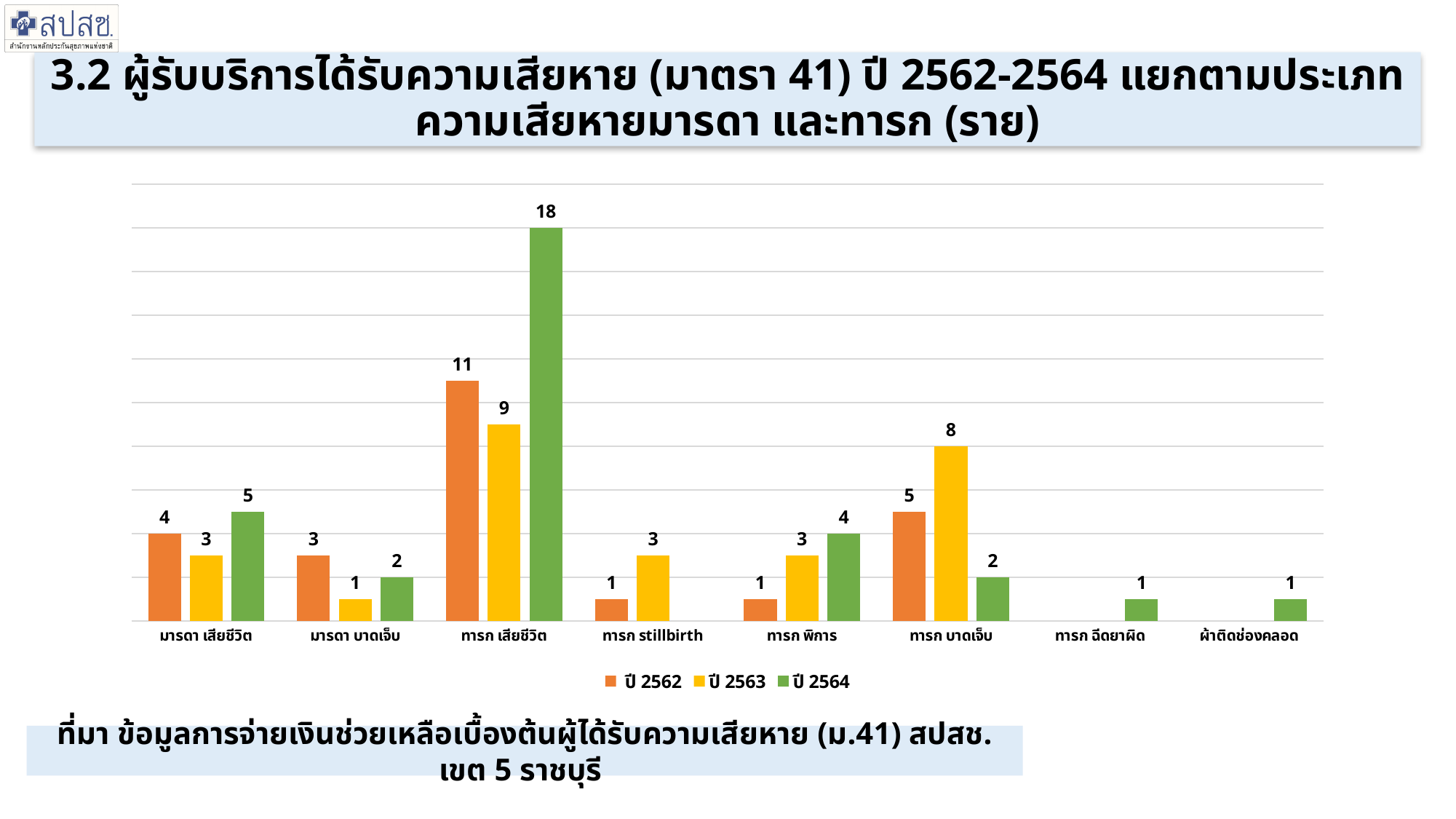
How many categories are shown on the x axis of the chart? 8 In the มารดา บาดเจ็บ category, which is larger: the value for ปี 2562 or ปี 2564? ปี 2562 What kind of chart is shown on the slide? bar chart What is the difference between the ปี 2564 and ปี 2562 values in the ทารก เสียชีวิต category? 7 What is the difference between the ปี 2563 and ปี 2564 values in the ทารก บาดเจ็บ category? 6 What is the value for ปี 2564 in the ทารก เสียชีวิต category? 18 Which category has the highest value for ปี 2563? ทารก เสียชีวิต What is the value for ปี 2564 in the มารดา เสียชีวิต category? 5 How many series does the legend list? 3 What is the value for ปี 2562 in the ทารก เสียชีวิต category? 11 What is the value for ปี 2563 in the ทารก บาดเจ็บ category? 8 Which category has the highest value for ปี 2564? ทารก เสียชีวิต